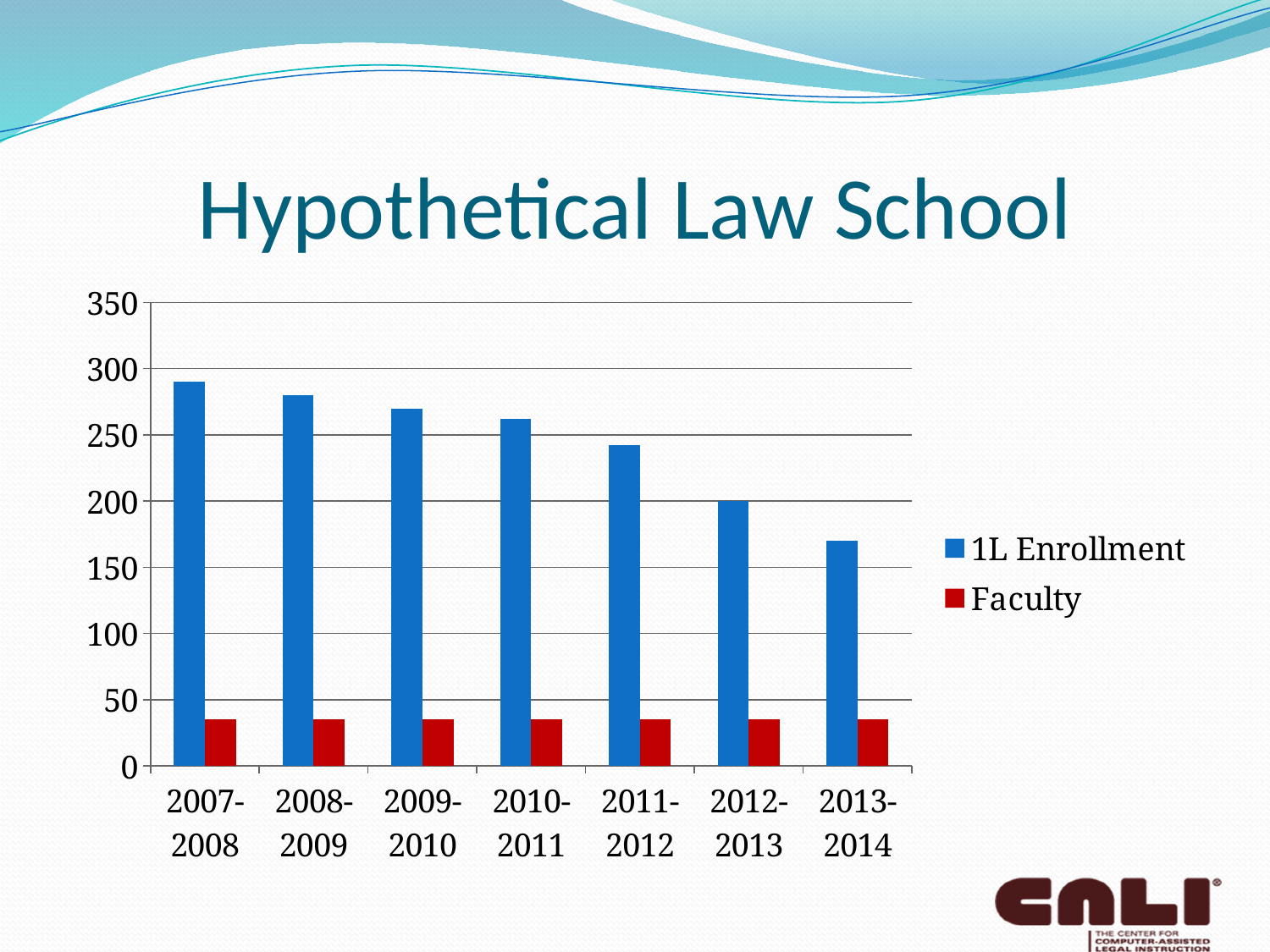
How many academic years are shown on the x axis? 7 Is the Faculty value for 2010-2011 greater or less than 50? less How many series does the legend list? 2 What is the title of the chart? Hypothetical Law School Which is larger in 2011-2012, 1L Enrollment or Faculty? 1L Enrollment Which academic year has the highest 1L Enrollment? 2007-2008 Is the 1L Enrollment for 2013-2014 greater or less than 200? less Which academic year has the lowest 1L Enrollment? 2013-2014 Does 1L Enrollment rise or fall from 2007-2008 to 2013-2014? fall Is the 1L Enrollment for 2007-2008 greater or less than 250? greater What colour are the Faculty bars? red What kind of chart is shown on the slide? bar chart